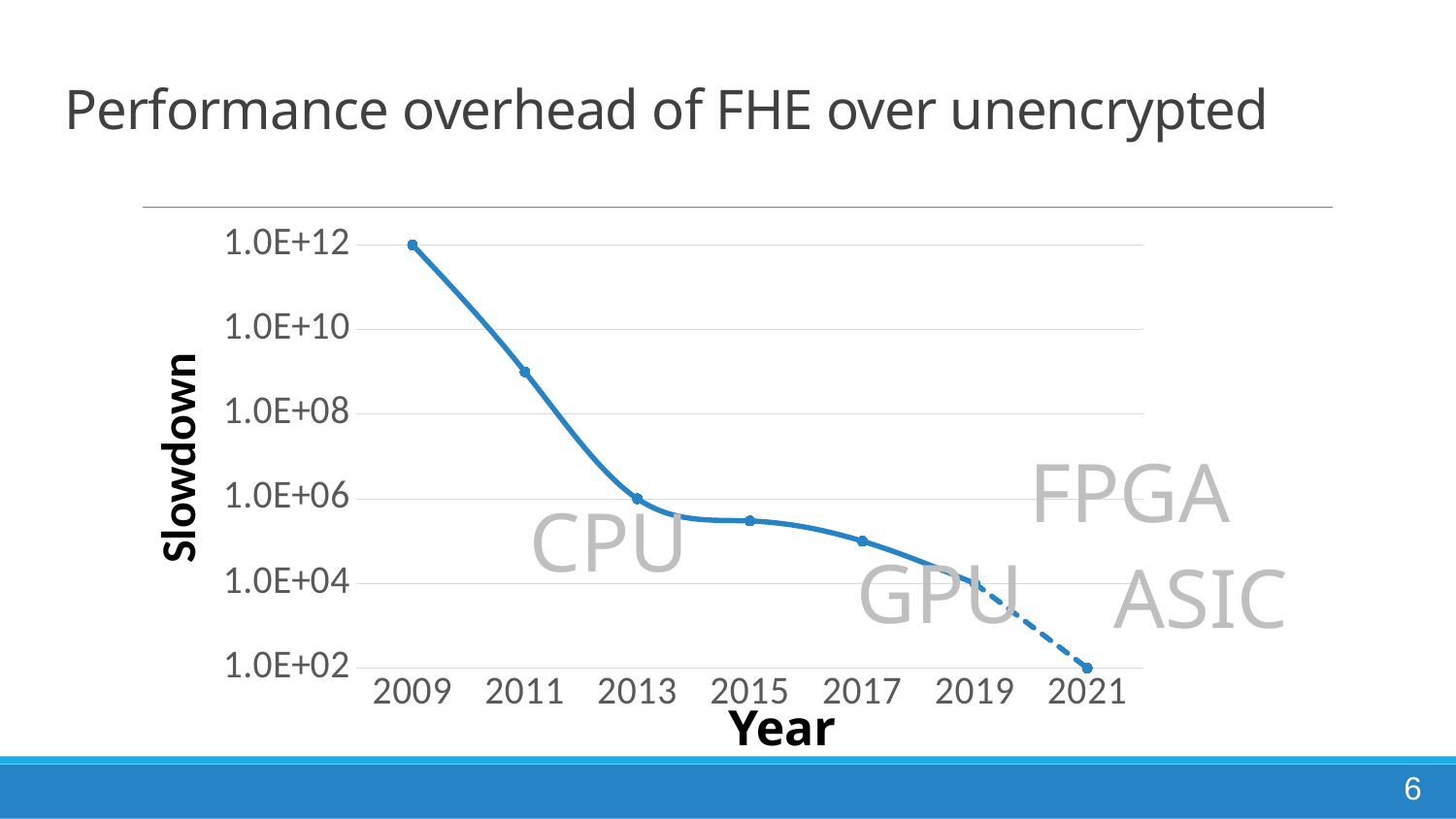
How many data points are plotted on the line? 7 Which year has the lowest slowdown value? 2021 What is the slowdown value plotted for 2013? 1.0E+06 Do the slowdown values rise or fall as the year increases? fall Is the slowdown value for 2011 greater or less than 1.0E+08? greater What kind of chart is shown on the slide? line chart Is the slowdown value for 2017 greater or less than 1.0E+04? greater What is the slowdown value plotted for 2009? 1.0E+12 Which year has the larger slowdown value, 2011 or 2015? 2011 Which year has the highest slowdown value? 2009 What is the slowdown value plotted for 2021? 1.0E+02 Is the slowdown value for 2015 greater or less than 1.0E+06? less